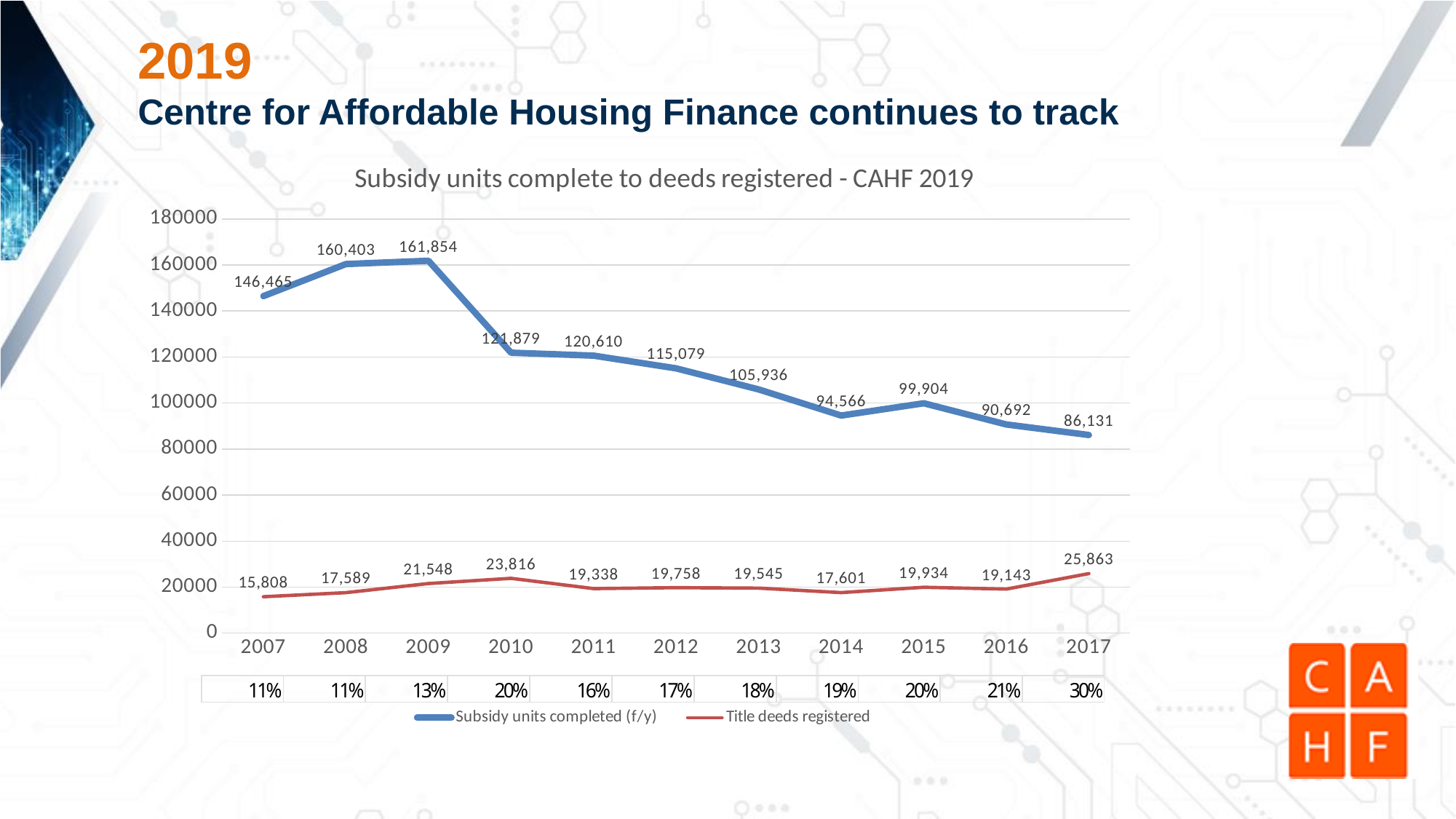
What is the value of Subsidy units completed (f/y) in 2009? 161,854 What kind of chart is shown on the slide? Line chart Which is larger, Subsidy units completed (f/y) in 2014 or in 2015? 2015 Does Subsidy units completed (f/y) rise or fall from 2009 to 2014? Fall What is the difference between Subsidy units completed (f/y) and Title deeds registered in 2007? 130,657 How many years are shown on the x axis? 11 What is the value of Title deeds registered in 2017? 25,863 In which year is Subsidy units completed (f/y) highest? 2009 In which year is Title deeds registered lowest? 2007 In which year is Title deeds registered highest? 2017 In which year is Subsidy units completed (f/y) lowest? 2017 How many series does the legend list? 2